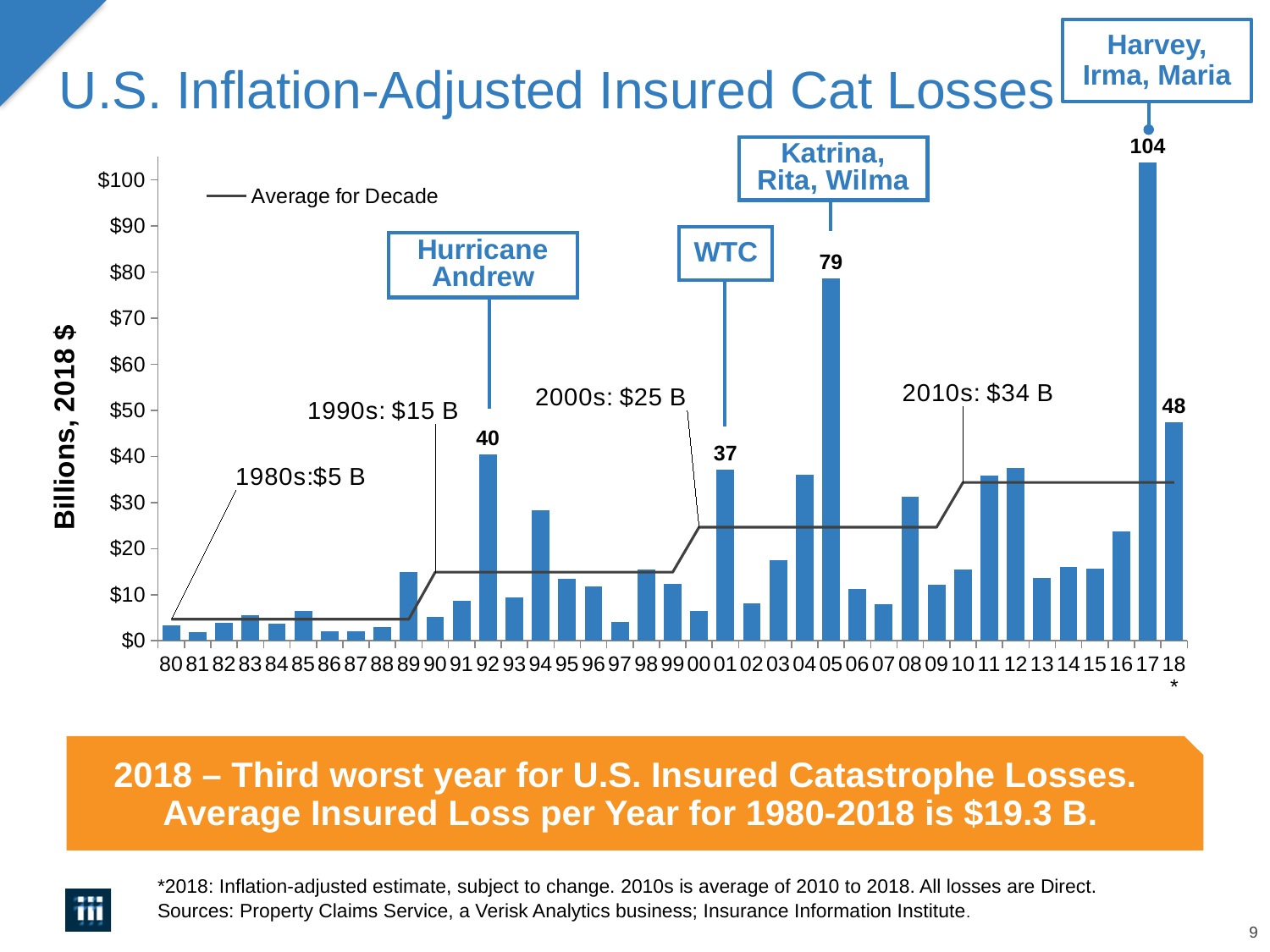
What is the insured cat loss value labeled for 2005? 79 What is the insured cat loss value labeled for 2017? 104 Which year has the larger insured cat loss, 2005 or 1992? 2005 What type of chart is shown on the slide? combination bar and line chart What does the line in the legend represent? Average for Decade What is the insured cat loss value labeled for 2018? 48 What is the difference between the labeled values for 1992 and 2001? 3 Which year has the highest insured cat losses? 2017 What is the average insured cat loss for the 2010s shown on the chart? $34 B Is the value for 2004 greater or less than $30 billion? greater What is the insured cat loss value labeled for 1992? 40 What is the difference between the labeled values for 2017 and 2005? 25